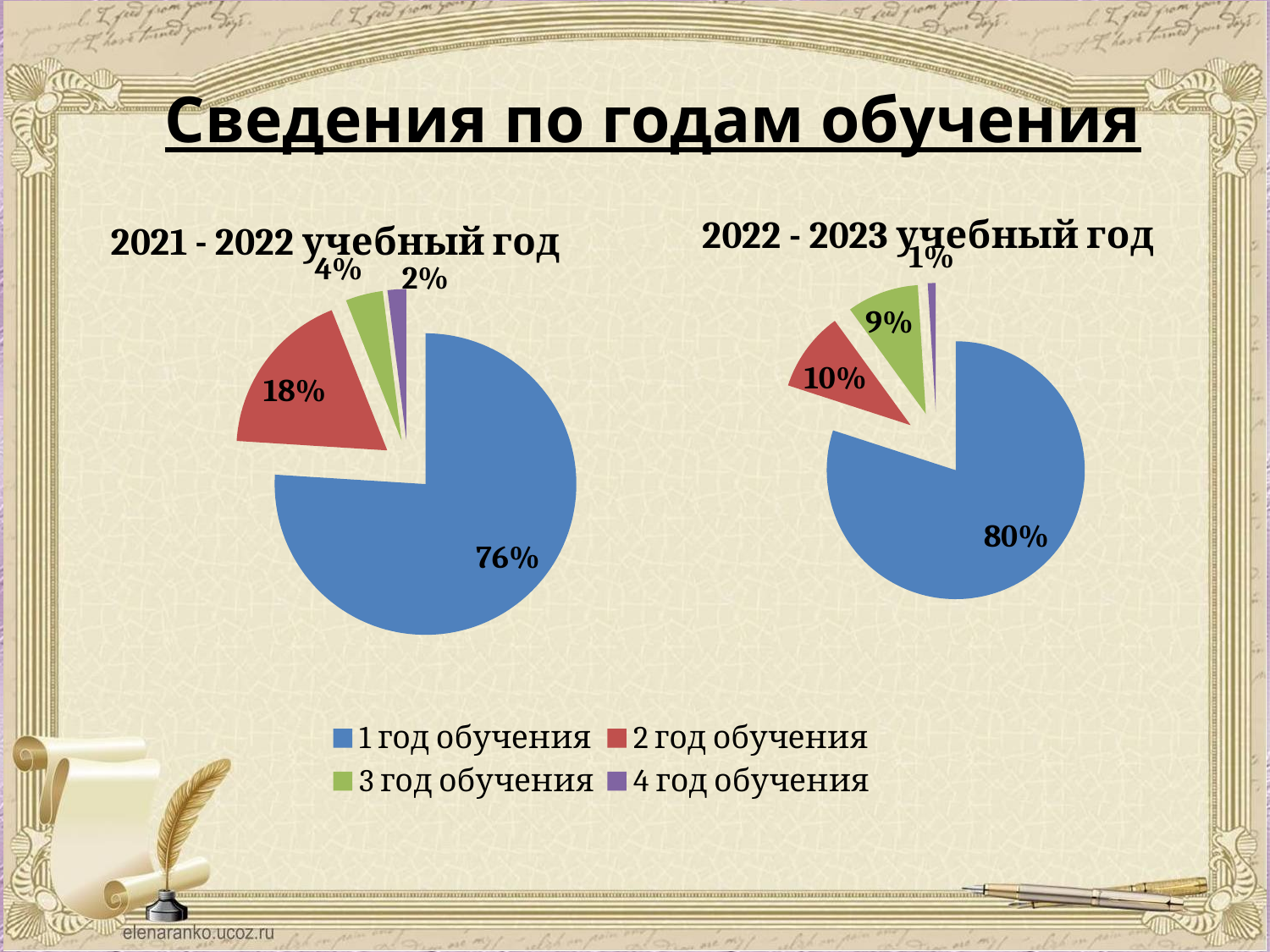
How many entries does the legend list? 4 Which is larger: the share for "2 год обучения" in the "2021 - 2022 учебный год" chart or in the "2022 - 2023 учебный год" chart? 2021 - 2022 учебный год What colour represents "3 год обучения" in the legend? Green How many slices does the "2022 - 2023 учебный год" chart have? 4 In the "2022 - 2023 учебный год" chart, what share is shown for "2 год обучения"? 10% What type of chart is the "2021 - 2022 учебный год" chart? Pie chart In the "2022 - 2023 учебный год" chart, what share is shown for "4 год обучения"? 1% In the "2021 - 2022 учебный год" chart, what share is shown for "1 год обучения"? 76% In the "2022 - 2023 учебный год" chart, which category has the smallest slice? 4 год обучения In the "2021 - 2022 учебный год" chart, which category has the largest slice? 1 год обучения In the "2021 - 2022 учебный год" chart, what is the difference between the shares for "1 год обучения" and "2 год обучения"? 58% In the "2021 - 2022 учебный год" chart, what share is shown for "3 год обучения"? 4%